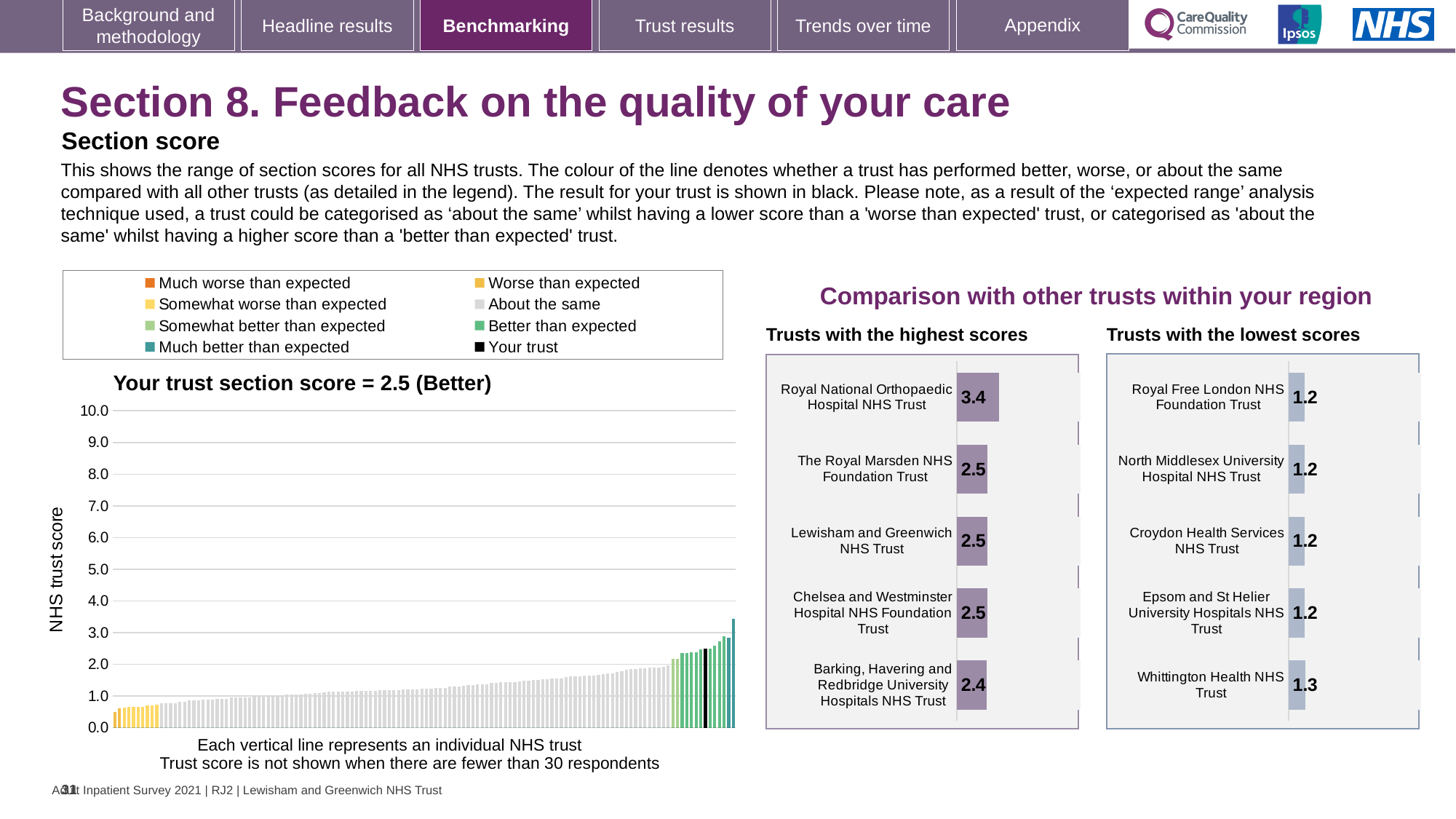
What kind of chart is the 'Your trust section score = 2.5 (Better)' chart? bar chart In the 'Your trust section score' chart, is the value of the tallest bar greater or less than 3.0? greater In the 'Your trust section score' chart, do the bar values rise or fall from left to right? rise In the 'Trusts with the highest scores' chart, which trust has the lowest score? Barking, Havering and Redbridge University Hospitals NHS Trust In the 'Trusts with the lowest scores' chart, what is the difference between the scores of Whittington Health NHS Trust and Royal Free London NHS Foundation Trust? 0.1 In the 'Trusts with the highest scores' chart, what is the difference between the scores of Royal National Orthopaedic Hospital NHS Trust and Barking, Havering and Redbridge University Hospitals NHS Trust? 1.0 How many trusts are listed in the 'Trusts with the lowest scores' chart? 5 In the 'Trusts with the highest scores' chart, what is the score for Barking, Havering and Redbridge University Hospitals NHS Trust? 2.4 Which is larger: the score for Royal National Orthopaedic Hospital NHS Trust in the 'Trusts with the highest scores' chart or the score for Whittington Health NHS Trust in the 'Trusts with the lowest scores' chart? Royal National Orthopaedic Hospital NHS Trust In the 'Trusts with the lowest scores' chart, what is the score for Whittington Health NHS Trust? 1.3 In the 'Trusts with the highest scores' chart, which trust has the highest score? Royal National Orthopaedic Hospital NHS Trust In the 'Trusts with the highest scores' chart, what is the score for Royal National Orthopaedic Hospital NHS Trust? 3.4